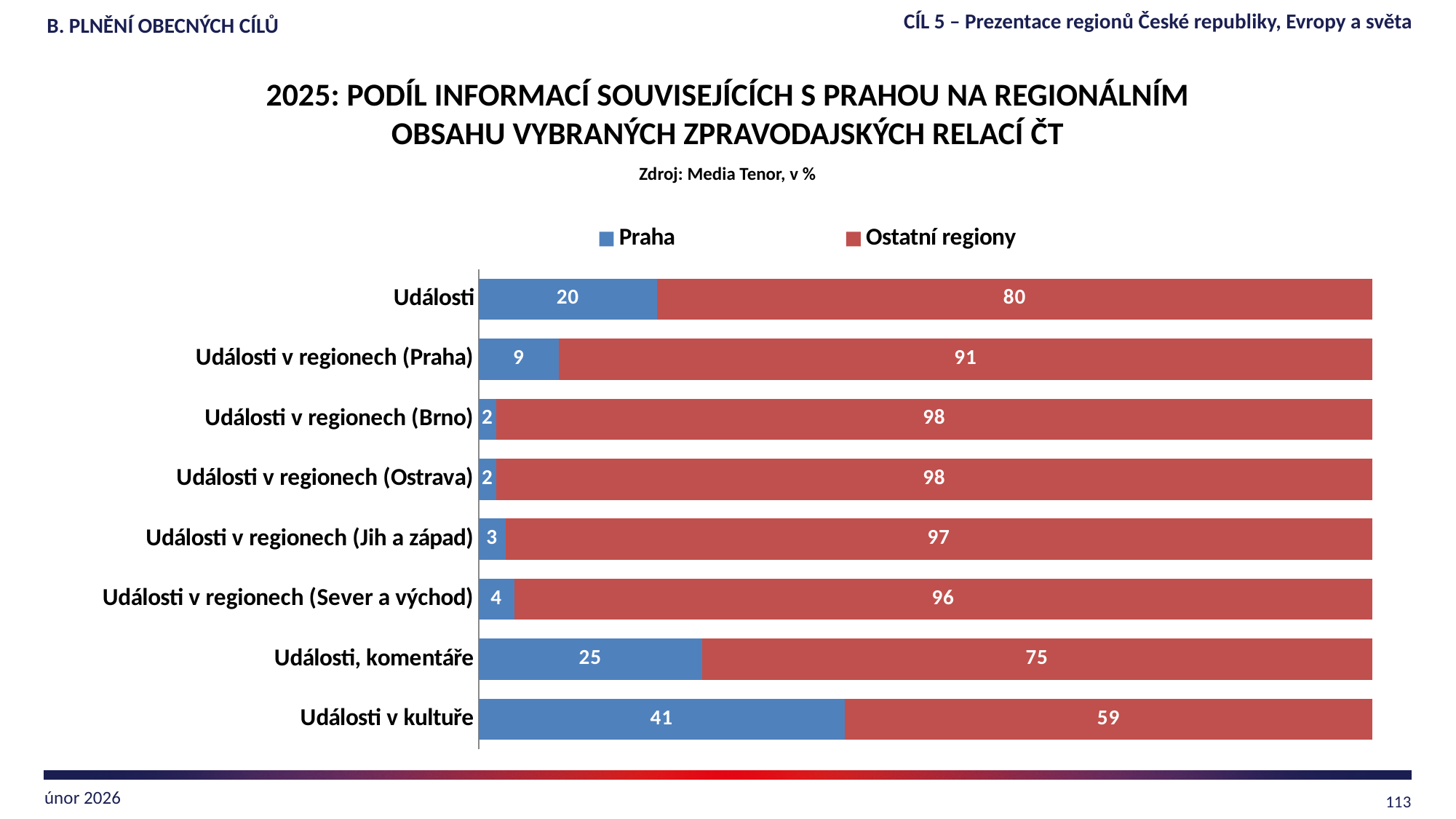
What is the Ostatní regiony value for Události v regionech (Praha)? 91 What is the Praha value for Události v kultuře? 41 What is the difference between the Ostatní regiony value and the Praha value for Události? 60 What kind of chart is shown on the slide? Stacked bar chart How many categories are shown on the chart? 8 Which category has the lowest Ostatní regiony value? Události v kultuře What is the Praha value for Události, komentáře? 25 Which is larger: the Praha value for Události, komentáře or the Praha value for Události? Události, komentáře What is the total of the stacked bar for Události v regionech (Sever a východ)? 100 How many series does the legend list? 2 Which category has the highest Praha value? Události v kultuře Which colour represents the Ostatní regiony series in the legend? Red